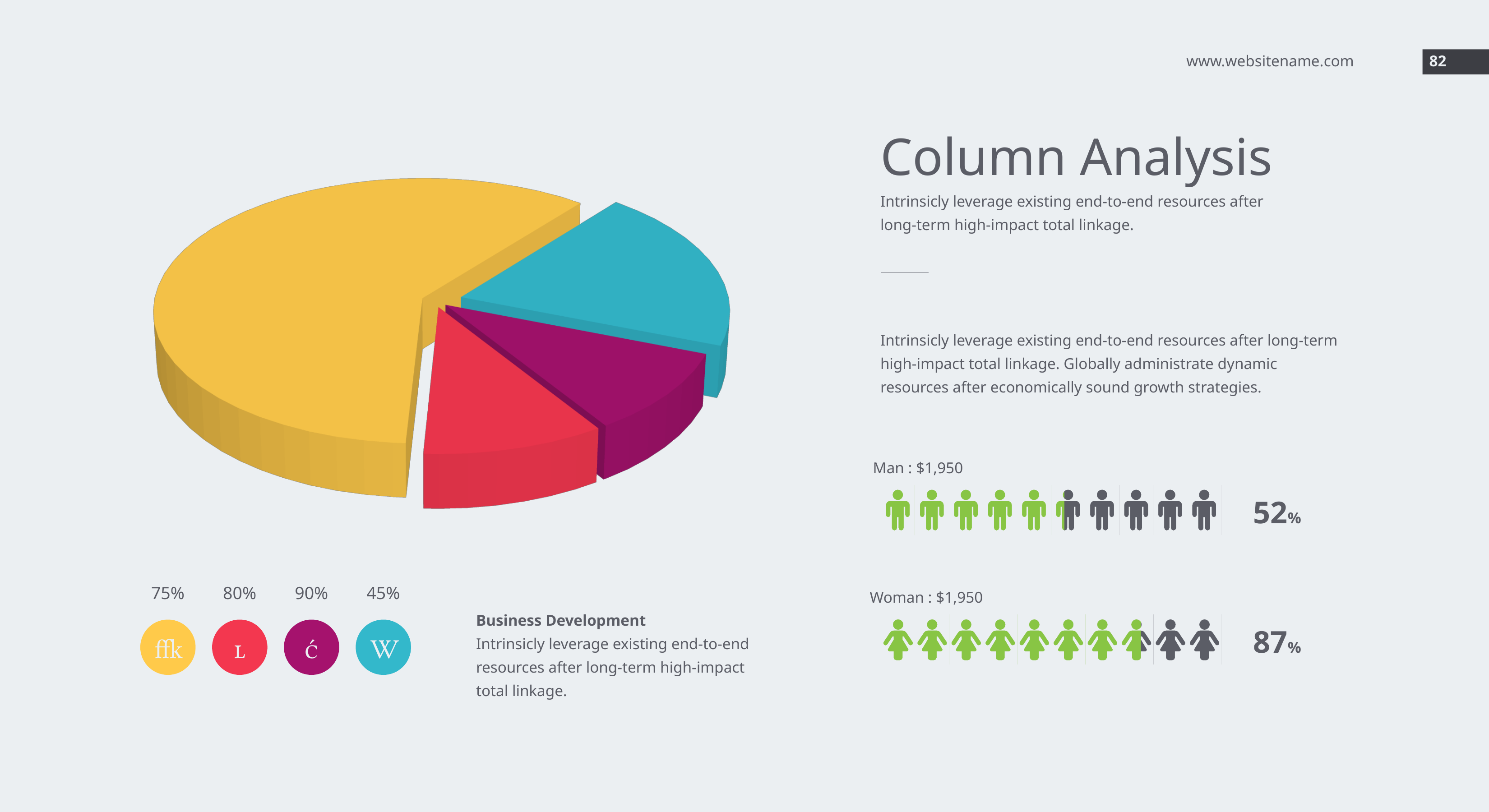
In the pictograph on the right, what is the difference between the Woman percentage and the Man percentage? 35% What kind of chart is shown on the left of the slide? pie chart How many slices does the pie chart on the left have? 4 What percentage is printed above the cyan circle labelled 'W' below the pie chart? 45% In the pictograph on the right, what percentage is shown for Woman? 87% In the pie chart on the left, is the yellow slice greater or less than 50% of the pie? greater Which colour slice is the largest in the pie chart on the left? yellow In the pie chart on the left, is the yellow slice larger or smaller than the cyan slice? larger What percentage is printed above the yellow circle labelled 'ffk' below the pie chart? 75% In the pictograph on the right, what dollar amount is shown next to Man? $1,950 In the pictograph on the right, what percentage is shown for Man? 52% In the pictograph on the right, which has the higher percentage, Man or Woman? Woman